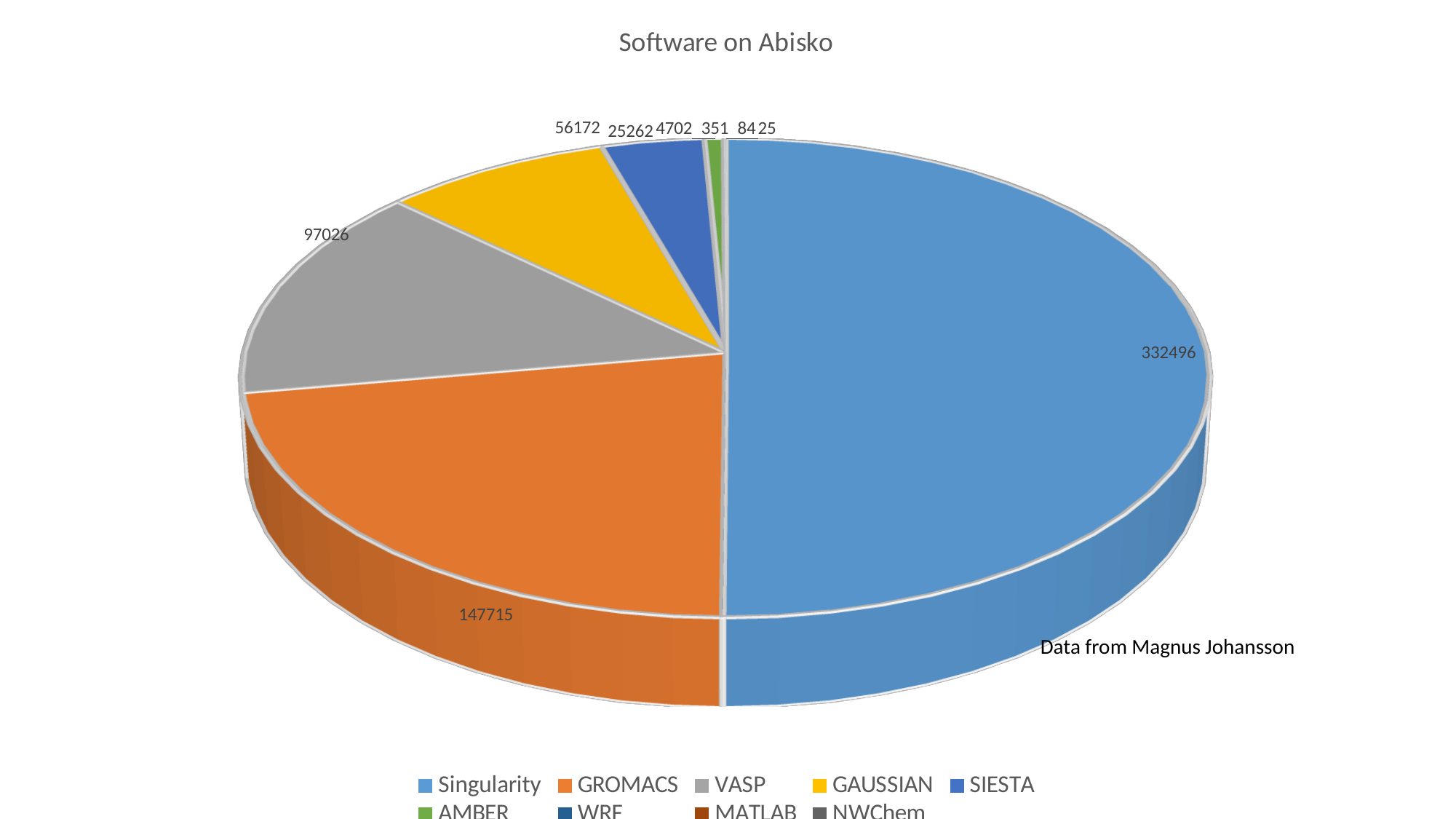
What kind of chart is shown on the slide? pie chart What is the value for GAUSSIAN? 56172 Which software has the smallest value? NWChem What is the value for Singularity? 332496 How many software categories does the legend list? 9 What is the value for SIESTA? 25262 What is the difference between the values for Singularity and GROMACS? 184781 Which is larger, the value for VASP or the value for GAUSSIAN? VASP What is the title of the chart? Software on Abisko Which software has the largest slice of the pie? Singularity What is the value for VASP? 97026 What is the value for GROMACS? 147715